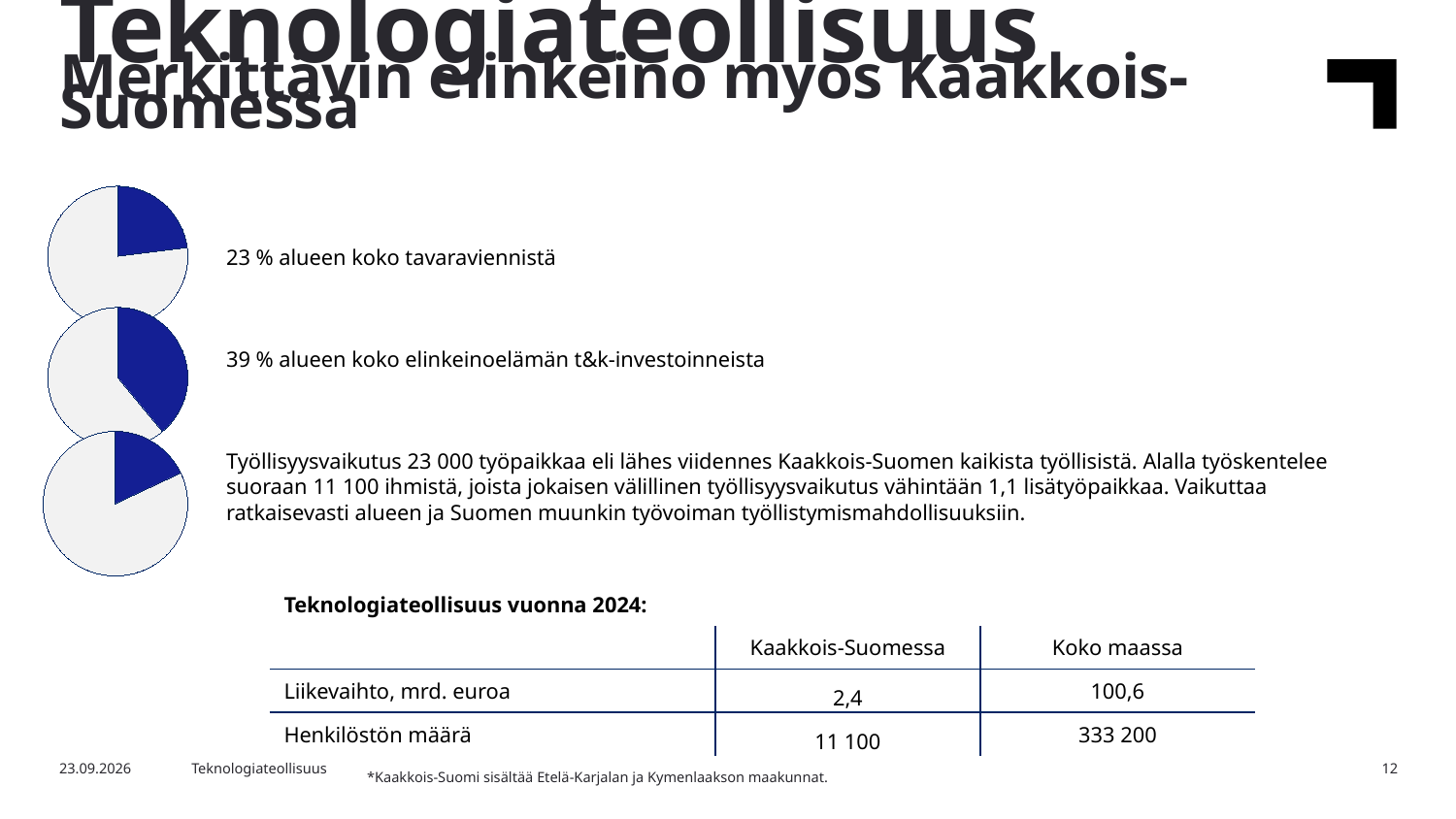
In the top pie chart, what share of the region's total goods exports (tavaravienti) does the blue slice represent? 23 % Which of the three pie charts has the smallest blue slice? The bottom one (työllisyysvaikutus) What colour is the highlighted slice in each pie chart? Blue How many slices does each pie chart have? 2 In the middle pie chart, what share of the region's business R&D investments (t&k-investoinnit) does the blue slice represent? 39 % What is the difference between the share shown in the middle pie chart (39 %) and the share shown in the top pie chart (23 %)? 16 percentage points What kind of charts are shown on the left side of the slide? Pie charts Which pie chart has the larger blue slice, the top one (tavaravienti) or the middle one (t&k-investoinnit)? The middle one (t&k-investoinnit) Which of the three pie charts has the largest blue slice? The middle one (t&k-investoinnit) How many pie charts are on the slide? 3